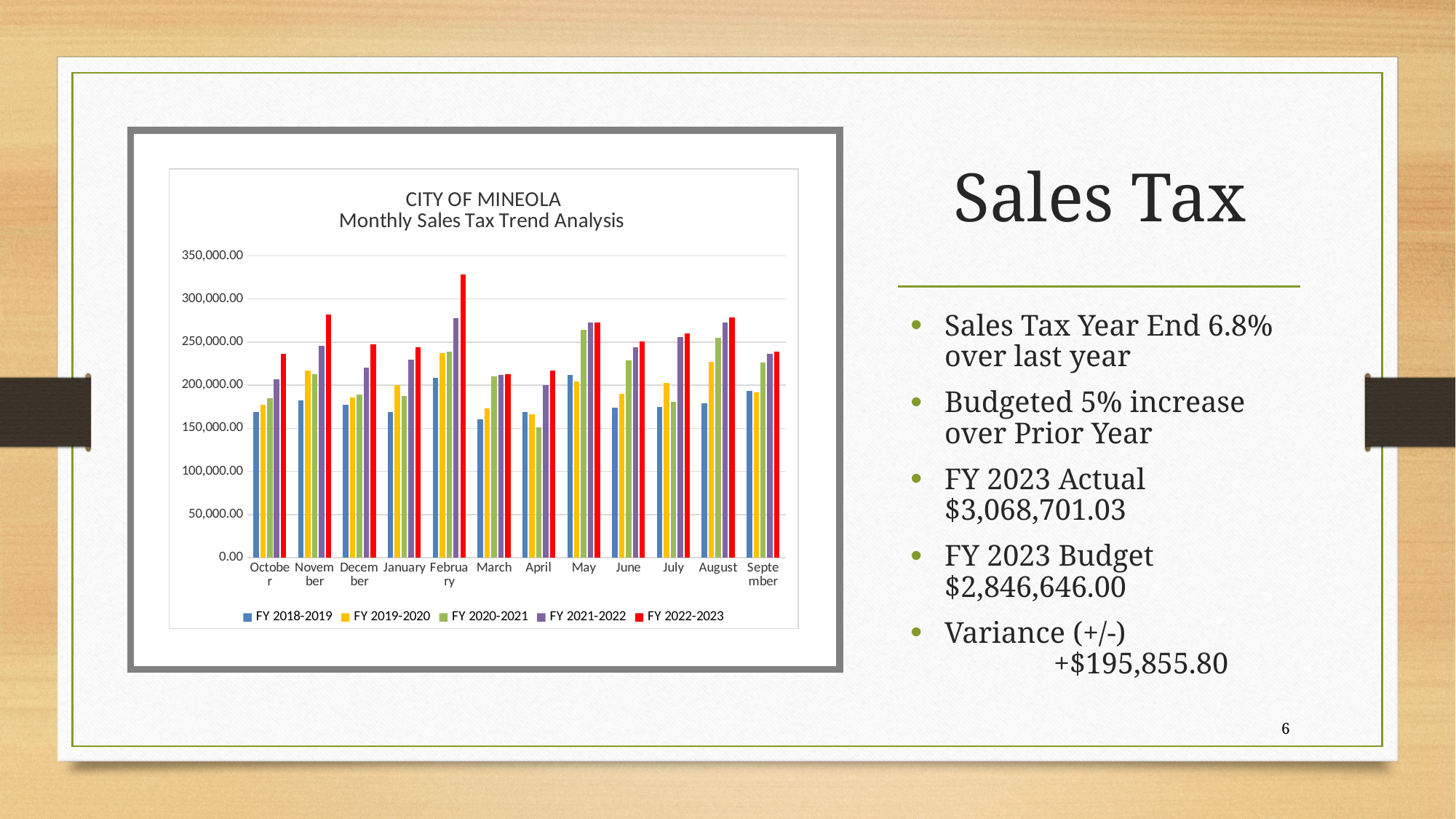
What is the title of the chart? CITY OF MINEOLA Monthly Sales Tax Trend Analysis What kind of chart is shown on the slide? Bar chart In which month is the FY 2022-2023 bar the highest? February How many series does the legend of the chart list? 5 Is the FY 2018-2019 value for October greater or less than 200,000.00? less Is the FY 2021-2022 value for February greater or less than 250,000.00? greater In November, which is larger: the FY 2022-2023 value or the FY 2018-2019 value? FY 2022-2023 What colour represents the FY 2022-2023 series in the chart? Red Is the FY 2022-2023 value for February greater or less than 300,000.00? greater How many months are shown along the x axis of the chart? 12 In which month is the FY 2018-2019 bar the lowest? March In April, which is larger: the FY 2019-2020 value or the FY 2020-2021 value? FY 2019-2020